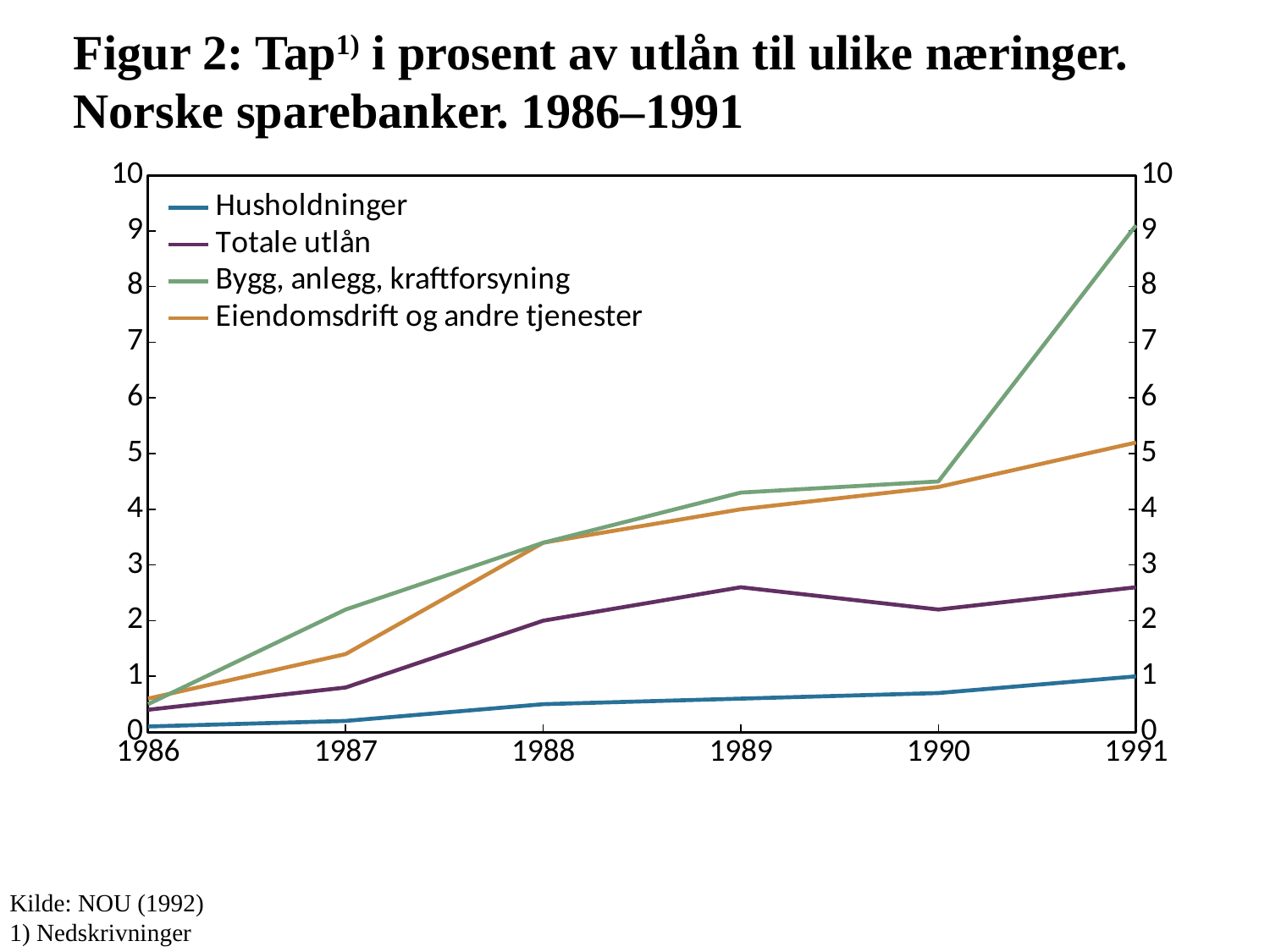
What colour is the line for Bygg, anlegg, kraftforsyning? green What is the value for Husholdninger in 1991? 1 Which series has the lowest value in 1991? Husholdninger Is the value for Bygg, anlegg, kraftforsyning in 1991 greater or less than 8? greater How many years are shown along the x axis? 6 Which series has the highest value in 1991? Bygg, anlegg, kraftforsyning Does the Husholdninger series rise or fall from 1986 to 1991? rise What kind of chart is shown on the slide? line chart Is the value for Eiendomsdrift og andre tjenester in 1987 greater or less than 2? less In 1987, which is larger: Bygg, anlegg, kraftforsyning or Eiendomsdrift og andre tjenester? Bygg, anlegg, kraftforsyning Is the value for Totale utlån in 1989 greater or less than 3? less How many series does the legend list? 4